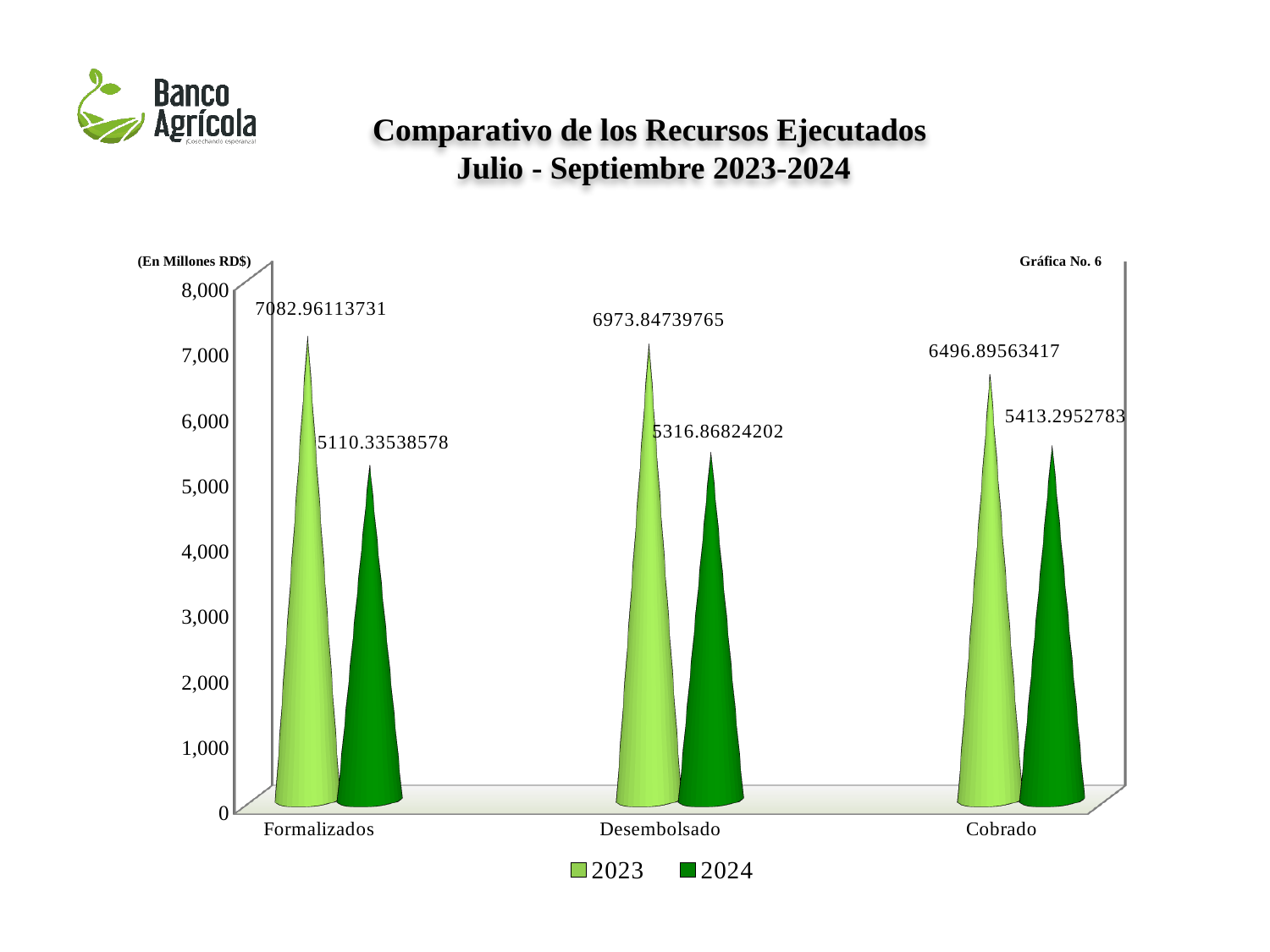
Which category has the lowest value in the 2024 series? Formalizados How many categories are shown on the x axis? 3 Which category has the highest value in the 2023 series? Formalizados What is the difference between the 2023 and 2024 values for Cobrado? 1083.60035587 What is the value for Formalizados in the 2023 series? 7082.96113731 Which is larger for Desembolsado, the 2023 value or the 2024 value? 2023 Do the 2023 values rise or fall from Formalizados to Cobrado? Fall What is the difference between the 2023 and 2024 values for Formalizados? 1972.62575153 How many series does the legend list? 2 What is the value for Cobrado in the 2023 series? 6496.89563417 What kind of chart is shown on the slide? Bar chart What is the value for Desembolsado in the 2024 series? 5316.86824202